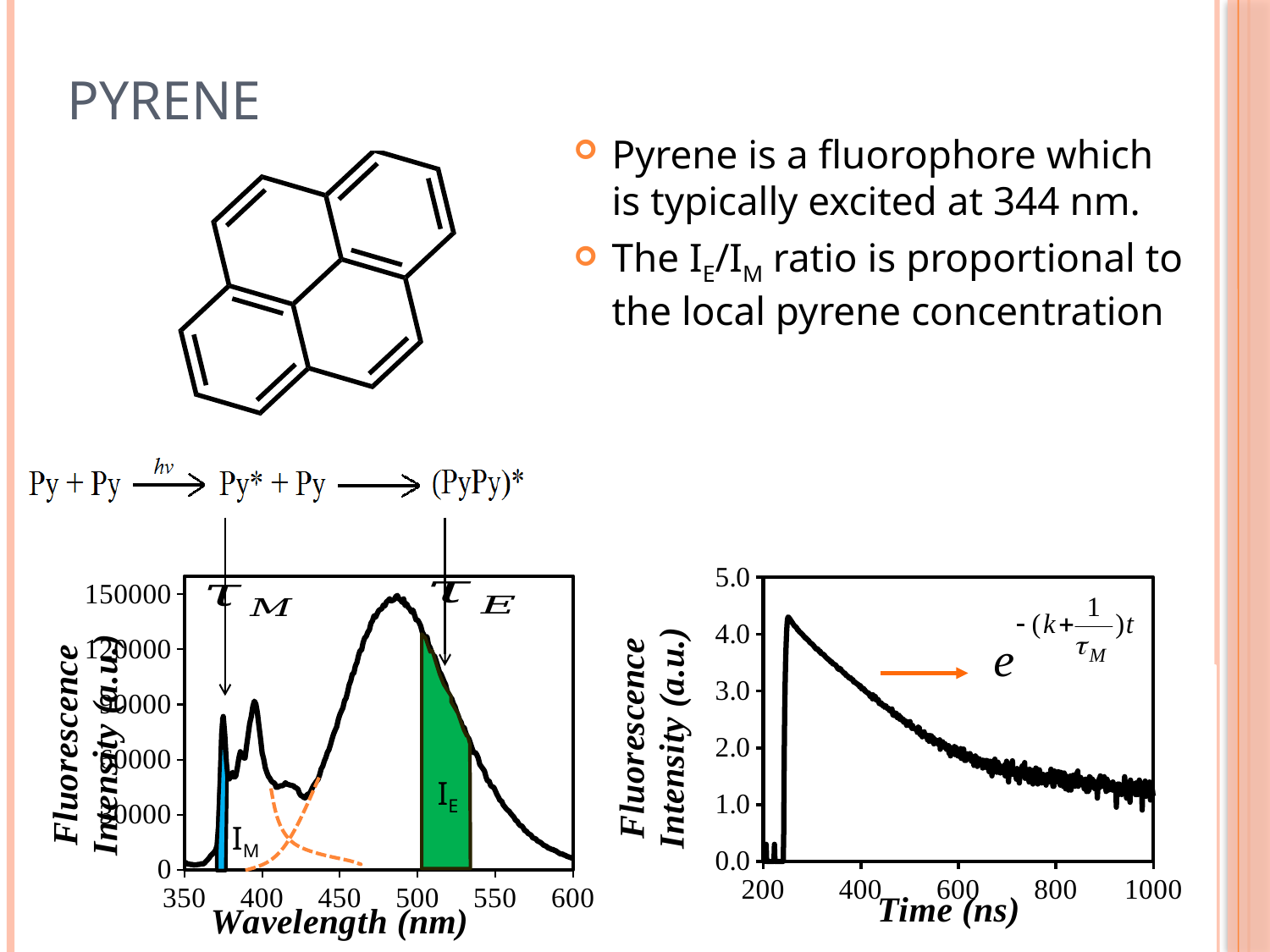
In the left chart, what is the label of the x axis? Wavelength (nm) In the right chart, what is the label of the x axis? Time (ns) What kind of chart is the right chart (Fluorescence Intensity vs Time)? line chart In the right chart, is the fluorescence intensity at 400 ns greater or less than 2.0? greater In the left chart, is the fluorescence intensity at 500 nm greater or less than 90000? greater In the left chart, do the values rise or fall as wavelength increases from 500 nm to 600 nm? fall In the right chart, is the peak fluorescence intensity greater or less than 4.0? greater In the right chart, do the values rise or fall as time increases from 400 ns to 1000 ns? fall What kind of chart is the left chart (Fluorescence Intensity vs Wavelength)? line chart